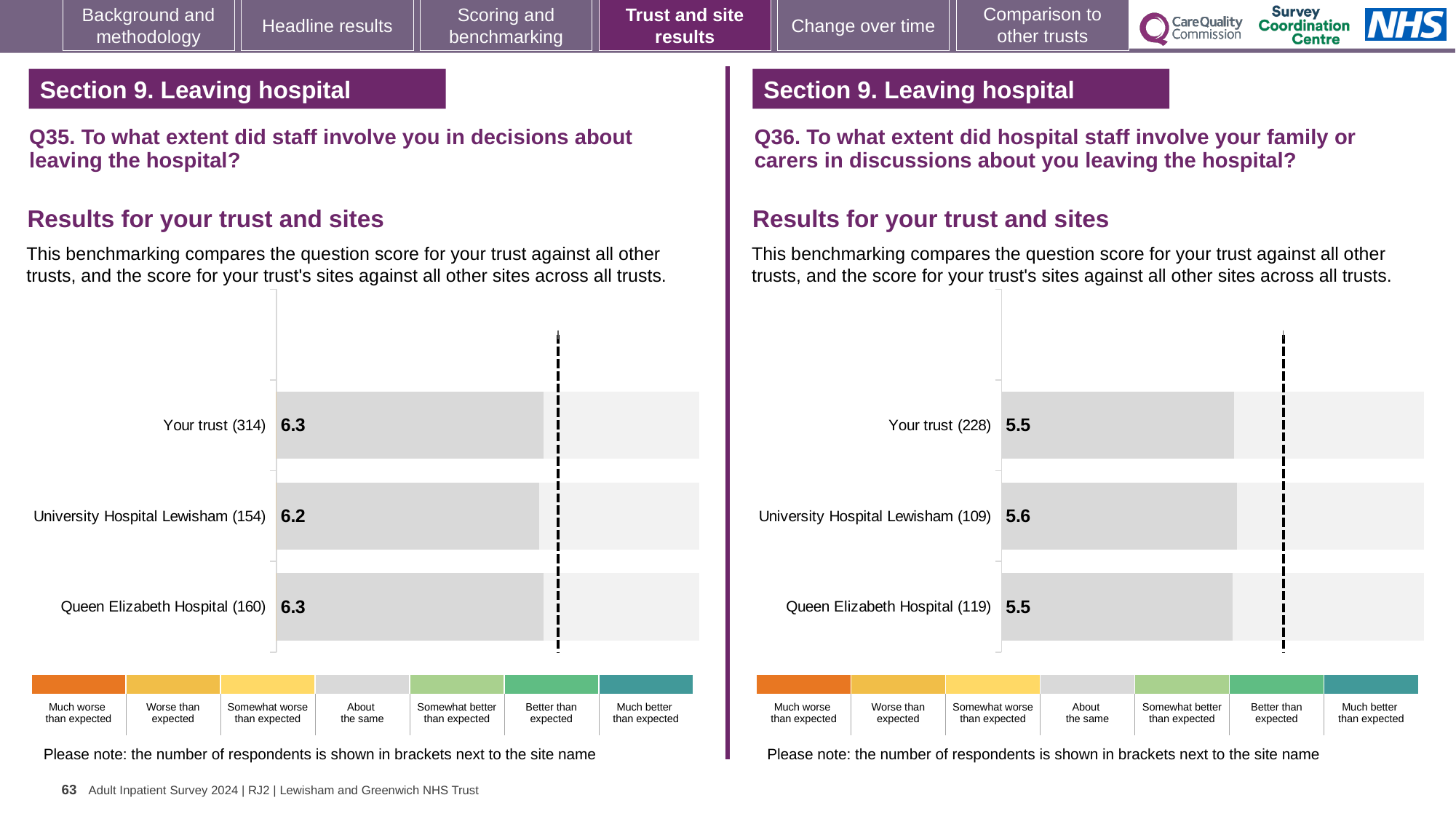
In the Q36 chart on the right, how many respondents are shown in brackets for Your trust? 228 In the Q36 chart on the right, what is the score for Queen Elizabeth Hospital? 5.5 How many categories does the colour key below the Q35 chart on the left list? 7 In the Q35 chart on the left, which site or trust has the lowest score? University Hospital Lewisham In the Q35 chart on the left, what is the score for Your trust? 6.3 In the Q35 chart on the left, what is the score for University Hospital Lewisham? 6.2 In the Q36 chart on the right, which site or trust has the highest score? University Hospital Lewisham How many bars are plotted in the Q35 chart on the left? 3 In the Q35 chart on the left, what is the difference between the score for Your trust and the score for University Hospital Lewisham? 0.1 In the Q36 chart on the right, is the score for University Hospital Lewisham larger or smaller than the score for Your trust? larger In the Q36 chart on the right, what is the score for University Hospital Lewisham? 5.6 What type of chart is used for the Q36 results on the right? bar chart